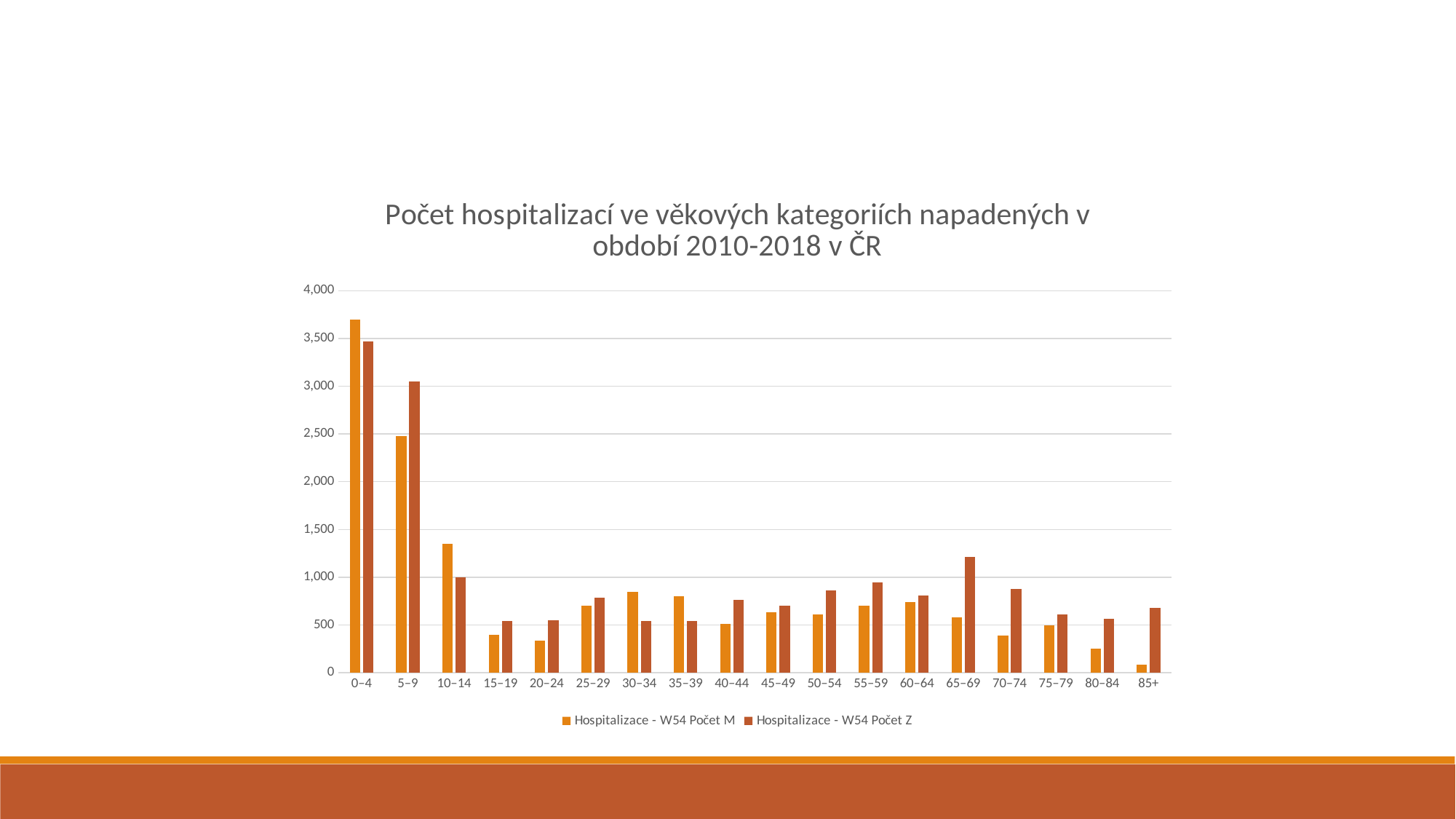
How many age categories are shown on the x axis? 18 How many series does the legend list? 2 What kind of chart is shown on the slide? bar chart In the 5–9 category, which series has the larger value, Hospitalizace - W54 Počet M or Hospitalizace - W54 Počet Z? Hospitalizace - W54 Počet Z Is the value for Hospitalizace - W54 Počet M in the 85+ category greater or less than 500? less Is the value for Hospitalizace - W54 Počet M in the 0–4 category greater or less than 3,500? greater Which age category has the lowest value for Hospitalizace - W54 Počet M? 85+ Which age category has the highest value for Hospitalizace - W54 Počet Z? 0–4 What is the title of the chart? Počet hospitalizací ve věkových kategoriích napadených v období 2010-2018 v ČR Is the value for Hospitalizace - W54 Počet Z in the 5–9 category greater or less than 3,000? greater In the 10–14 category, which series has the larger value, Hospitalizace - W54 Počet M or Hospitalizace - W54 Počet Z? Hospitalizace - W54 Počet M Which age category has the highest value for Hospitalizace - W54 Počet M? 0–4